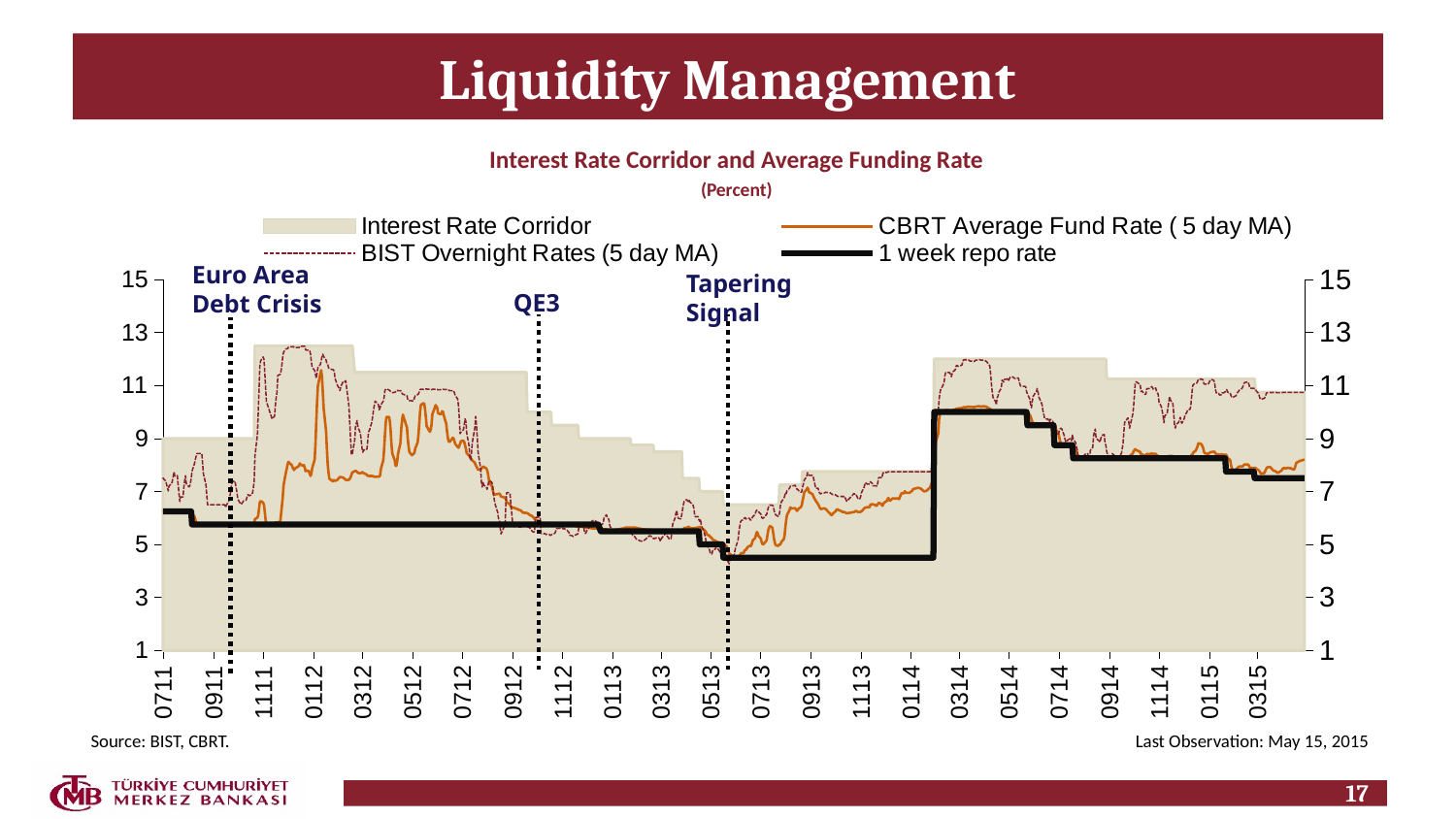
Is the 1 week repo rate at 0315 greater or less than 9? less How many series does the legend list? 4 Is the upper bound of the Interest Rate Corridor at 0112 greater or less than 11? greater Is the 1 week repo rate at 0314 greater or less than 9? greater How many date labels are shown on the x axis? 23 Does the 1 week repo rate rise or fall between 0314 and 0315? fall Which is larger at 0314: the 1 week repo rate or the 1 week repo rate at 0713? 0314 What unit is the chart measured in, according to the subtitle? Percent What is the title of the chart? Interest Rate Corridor and Average Funding Rate What kind of chart is shown on the slide? line chart